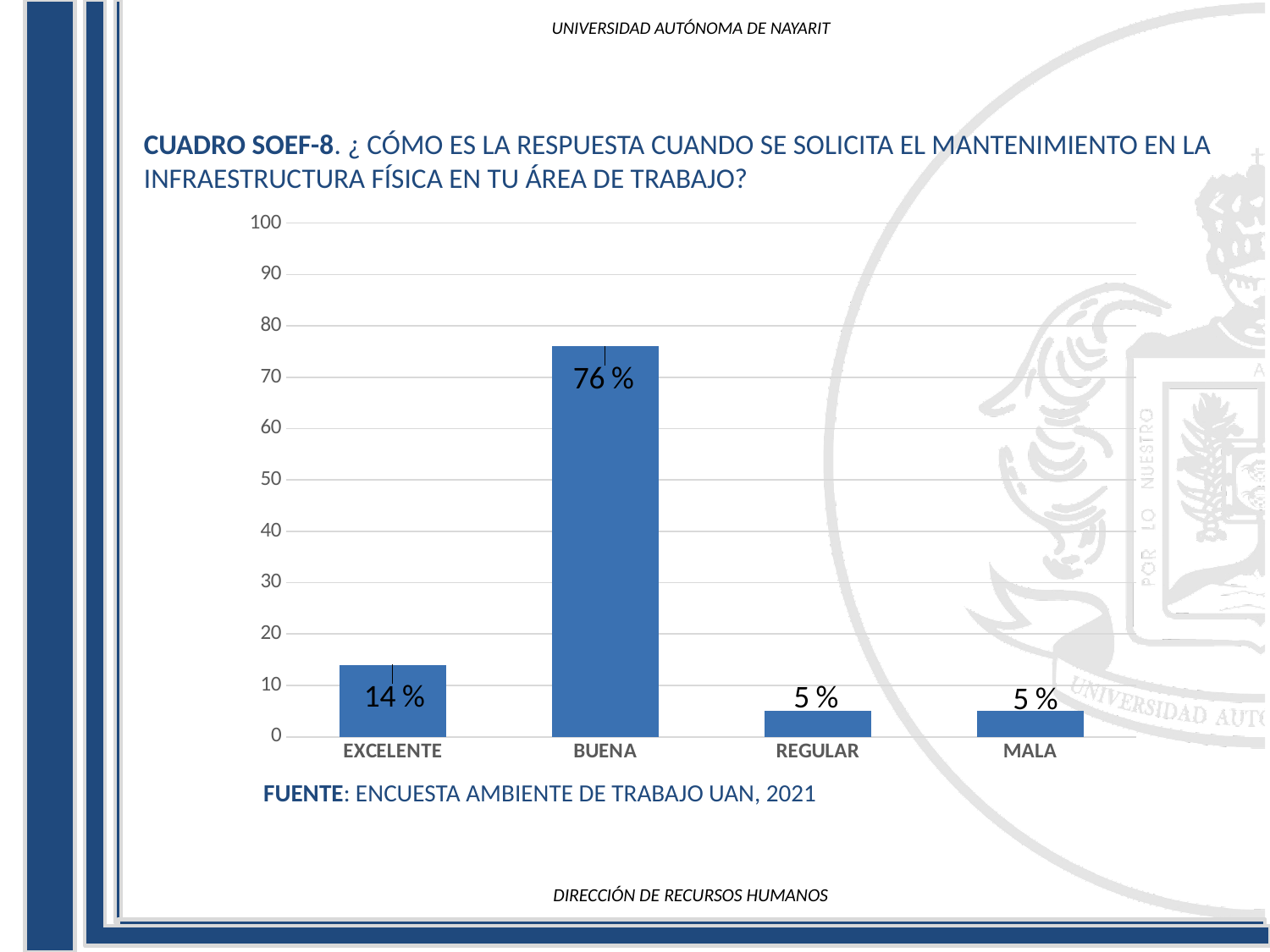
What is the value for EXCELENTE? 14 % What is the difference between the values for EXCELENTE and REGULAR? 9 % What kind of chart is shown on the slide? bar chart Is the value for BUENA greater or less than 70? greater Which is larger, the value for EXCELENTE or the value for MALA? EXCELENTE What is the difference between the values for BUENA and EXCELENTE? 62 % What is the value for REGULAR? 5 % What is the value for BUENA? 76 % Which category has the highest value? BUENA What source is cited below the chart? ENCUESTA AMBIENTE DE TRABAJO UAN, 2021 How many categories are shown on the x axis? 4 What is the value for MALA? 5 %